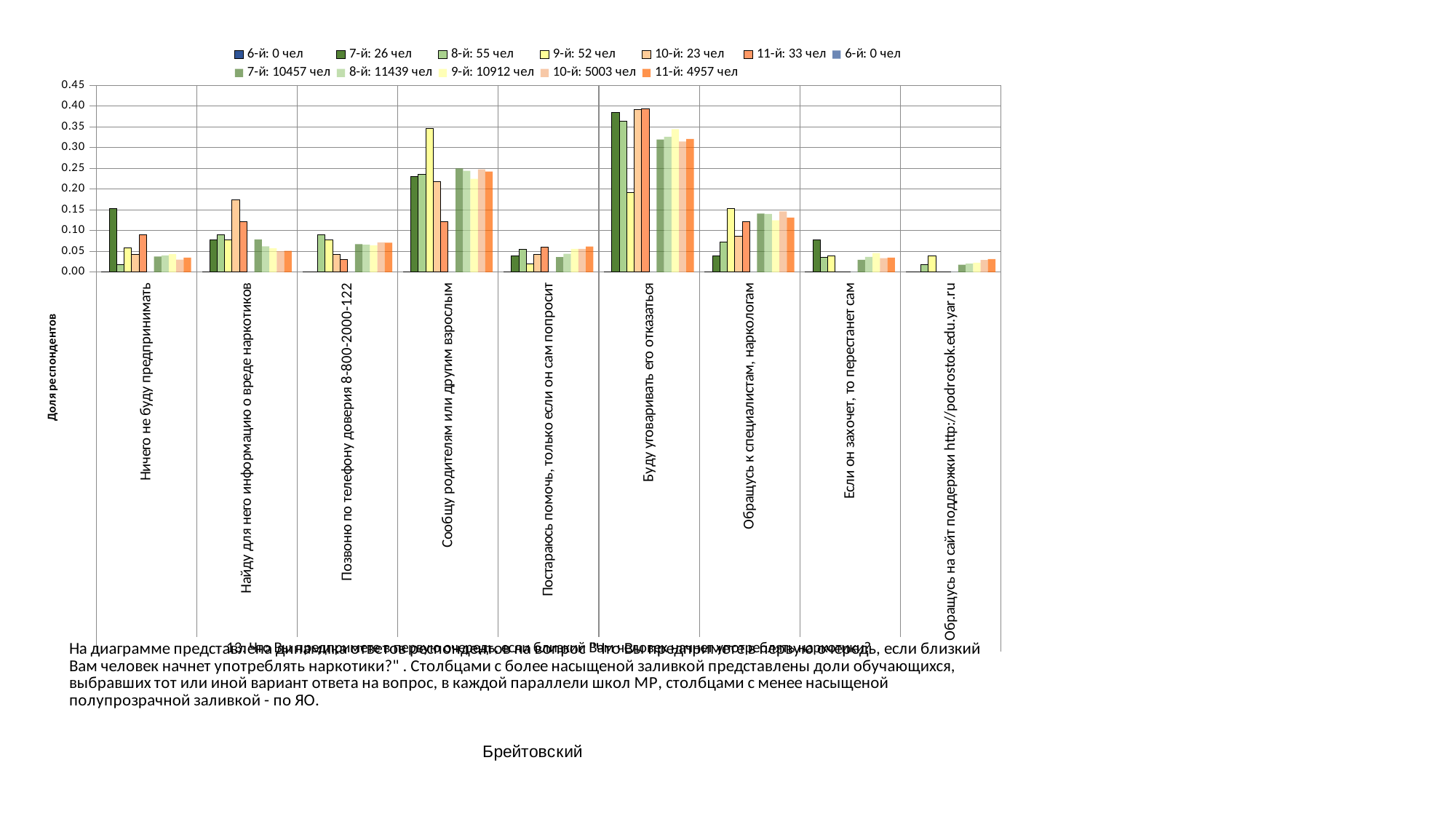
What kind of chart is shown on the slide? bar chart How many answer categories are shown along the x axis of the chart? 9 In the category 'Сообщу родителям или другим взрослым', which is larger: the value for '9-й: 52 чел' or for '7-й: 26 чел'? 9-й: 52 чел Is the value for '7-й: 26 чел' in the category 'Буду уговаривать его отказаться' greater or less than 0.35? greater Is the value for '7-й: 26 чел' in the category 'Если он захочет, то перестанет сам' greater or less than 0.10? less Is the value for '7-й: 26 чел' in the category 'Ничего не буду предпринимать' greater or less than 0.10? greater How many series does the chart's legend list? 12 Which category has the tallest bar in the chart? Буду уговаривать его отказаться What is the label of the chart's vertical axis? Доля респондентов In the category 'Буду уговаривать его отказаться', which is larger: the value for '7-й: 26 чел' or for '9-й: 52 чел'? 7-й: 26 чел